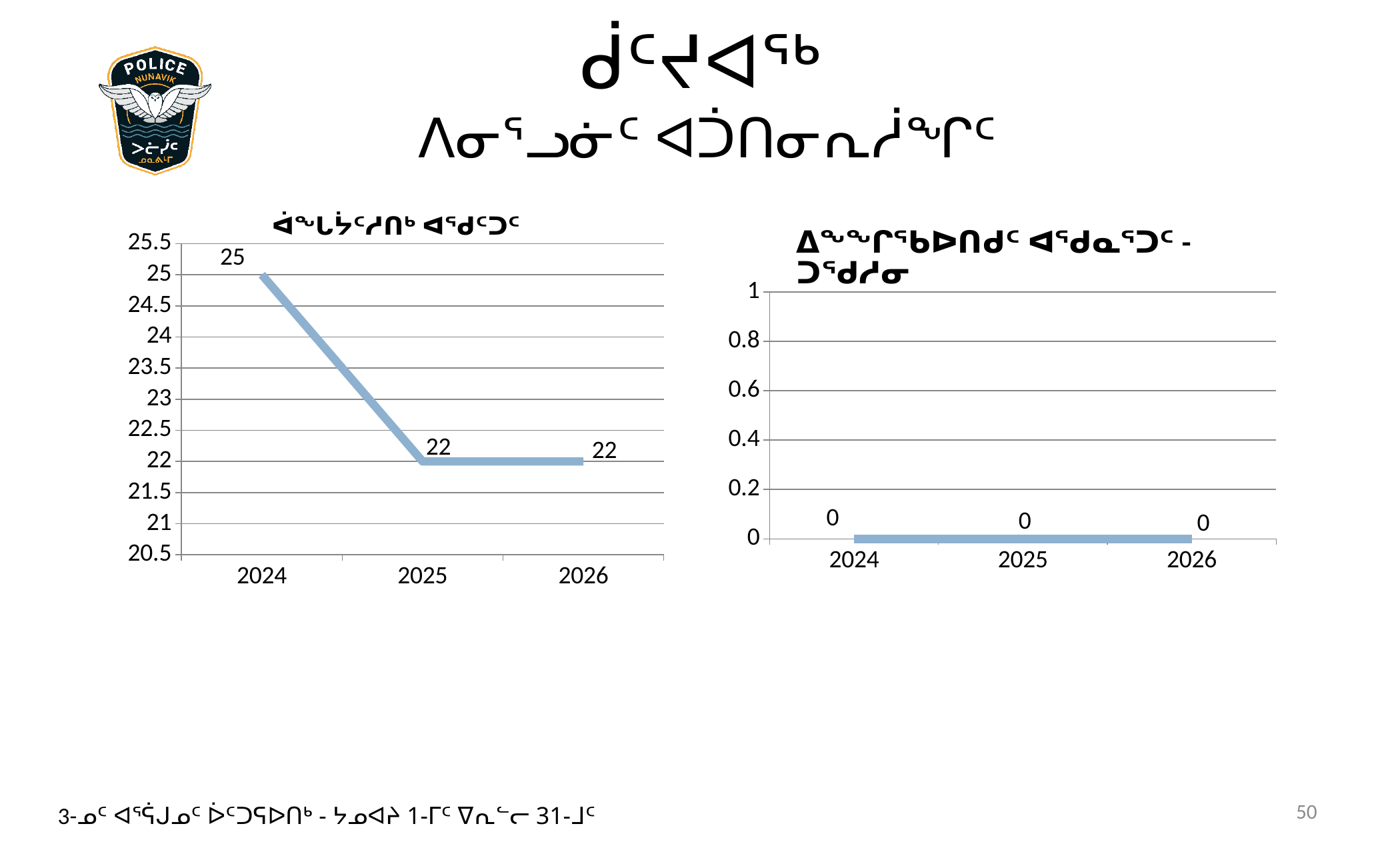
In the left chart, what is the value for 2024? 25 In the right chart, what is the value for 2025? 0 In the left chart, do the values rise or fall from 2024 to 2025? fall In the left chart, what is the value for 2025? 22 How many years are plotted on the left chart? 3 In the right chart, what is the highest value shown on the vertical axis? 1 In the left chart, what is the value for 2026? 22 In the left chart, what is the difference between the values for 2024 and 2025? 3 In the left chart, which year has the highest value? 2024 In the left chart, which is larger, the value for 2024 or the value for 2026? 2024 What kind of chart is the left chart? line chart In the left chart, is the value for 2024 greater or less than 24? greater